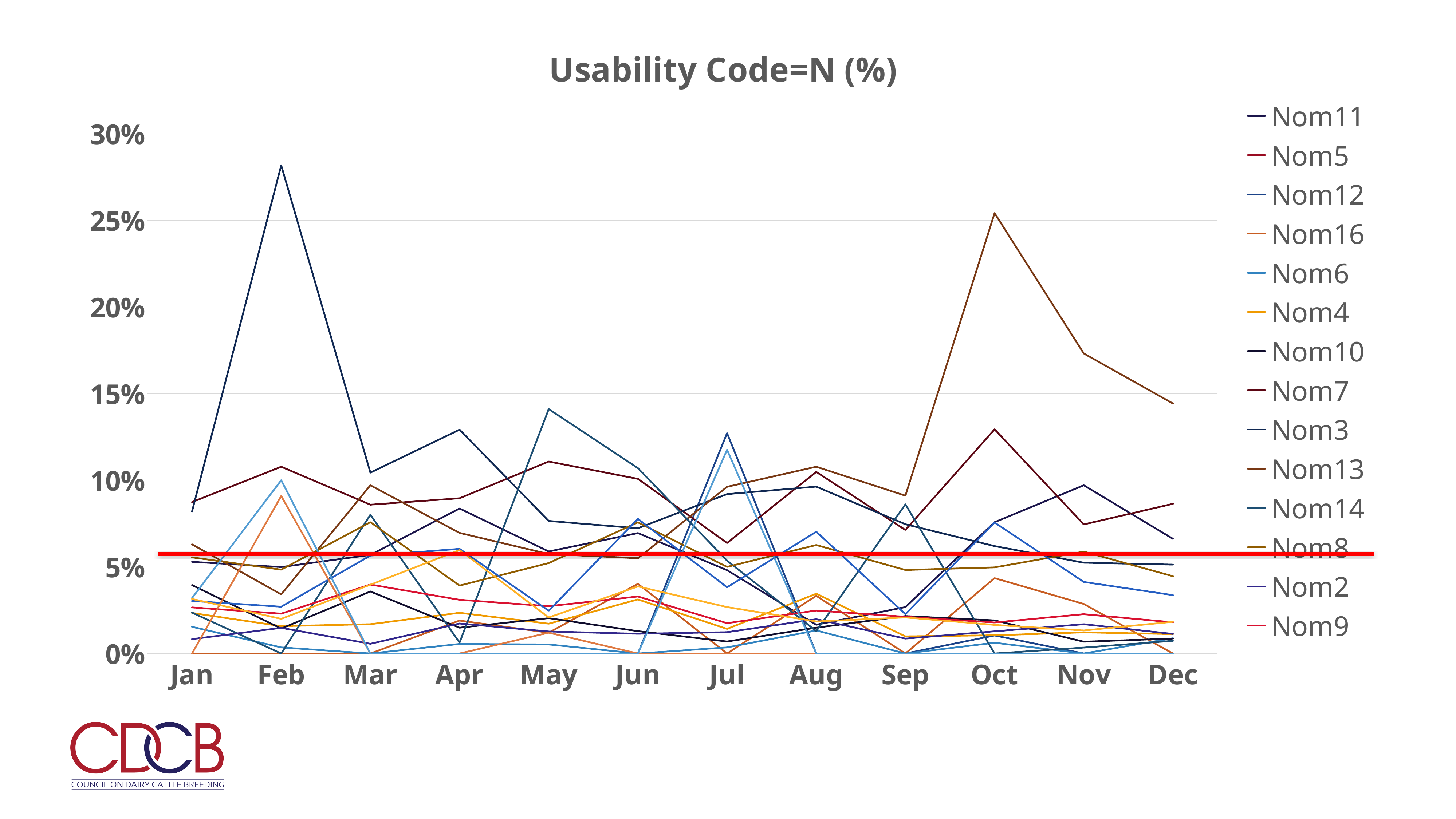
How many series does the legend list? 14 Does the Nom13 line rise or fall from Oct to Dec? fall In which month does the Nom11 line reach its highest value? Nov Is the value for Nom14 in May greater or less than 10%? greater Is the value for Nom16 in Feb greater or less than 10%? less In which month does the Nom13 line reach its highest value? Oct What is the title of the chart? Usability Code=N (%) Is the value for Nom11 in Feb greater or less than 25%? less What kind of chart is shown on the slide? line chart How many months are shown along the x axis? 12